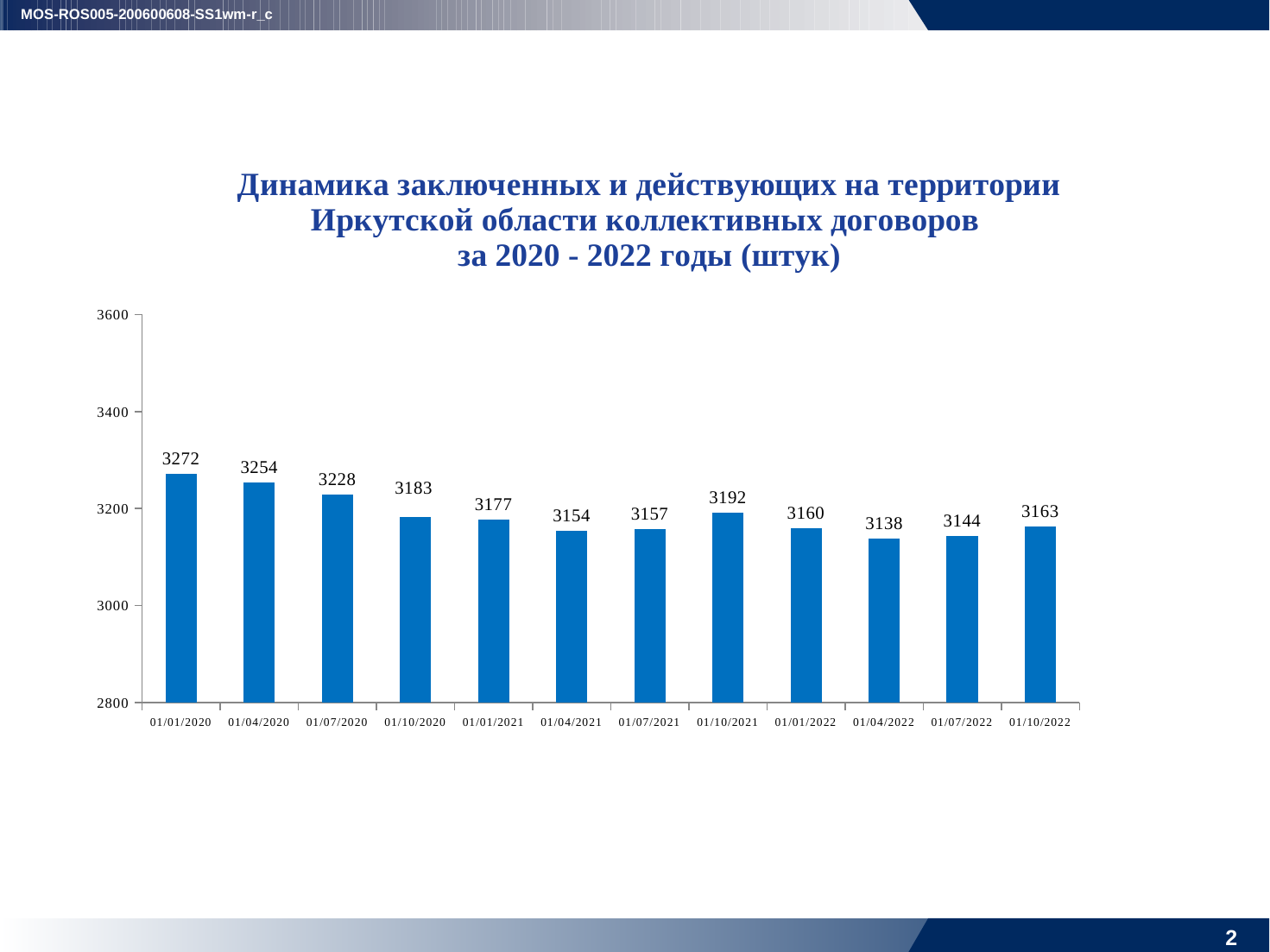
Is the value for 01/01/2020 greater or less than 3200? greater Which date has the highest value? 01/01/2020 What kind of chart is shown on the slide? bar chart Which date has the lowest value? 01/04/2022 Do the values generally rise or fall from 01/01/2020 to 01/10/2020? fall What is the difference between the values for 01/01/2020 and 01/10/2022? 109 What is the difference between the values for 01/10/2021 and 01/01/2022? 32 How many dates are shown on the x axis? 12 What is the value for 01/01/2020? 3272 What is the value for 01/04/2022? 3138 Which is larger, the value for 01/07/2020 or the value for 01/07/2021? 01/07/2020 What is the value for 01/10/2021? 3192